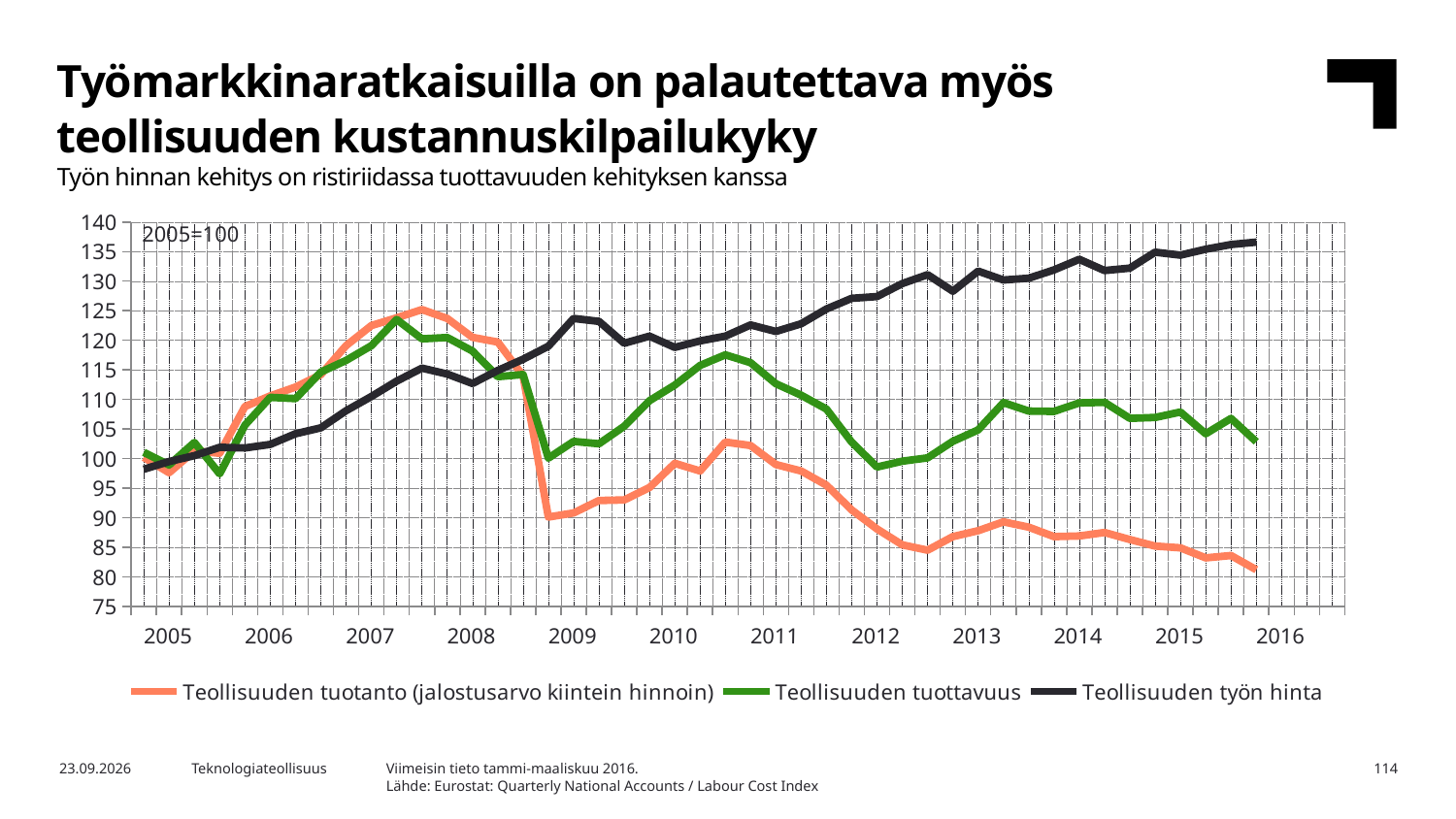
What base-year note is printed inside the chart area? 2005=100 Is the value for Teollisuuden tuottavuus at the end of the series (2016) greater or less than 100? greater Which series has the highest value at the end of the series (2016)? Teollisuuden työn hinta Is the value for Teollisuuden työn hinta at the end of the series (2016) greater or less than 130? greater Does Teollisuuden työn hinta rise or fall overall from 2005 to 2016? rise How many year labels are shown on the x axis? 12 What kind of chart is shown on the slide? line chart Is the value for Teollisuuden tuotanto at the start of 2009 greater or less than 95? less Which series has the lowest value at the end of the series (2016)? Teollisuuden tuotanto (jalostusarvo kiintein hinnoin) At the end of the series (2016), which is larger: Teollisuuden tuottavuus or Teollisuuden tuotanto? Teollisuuden tuottavuus How many series does the legend list? 3